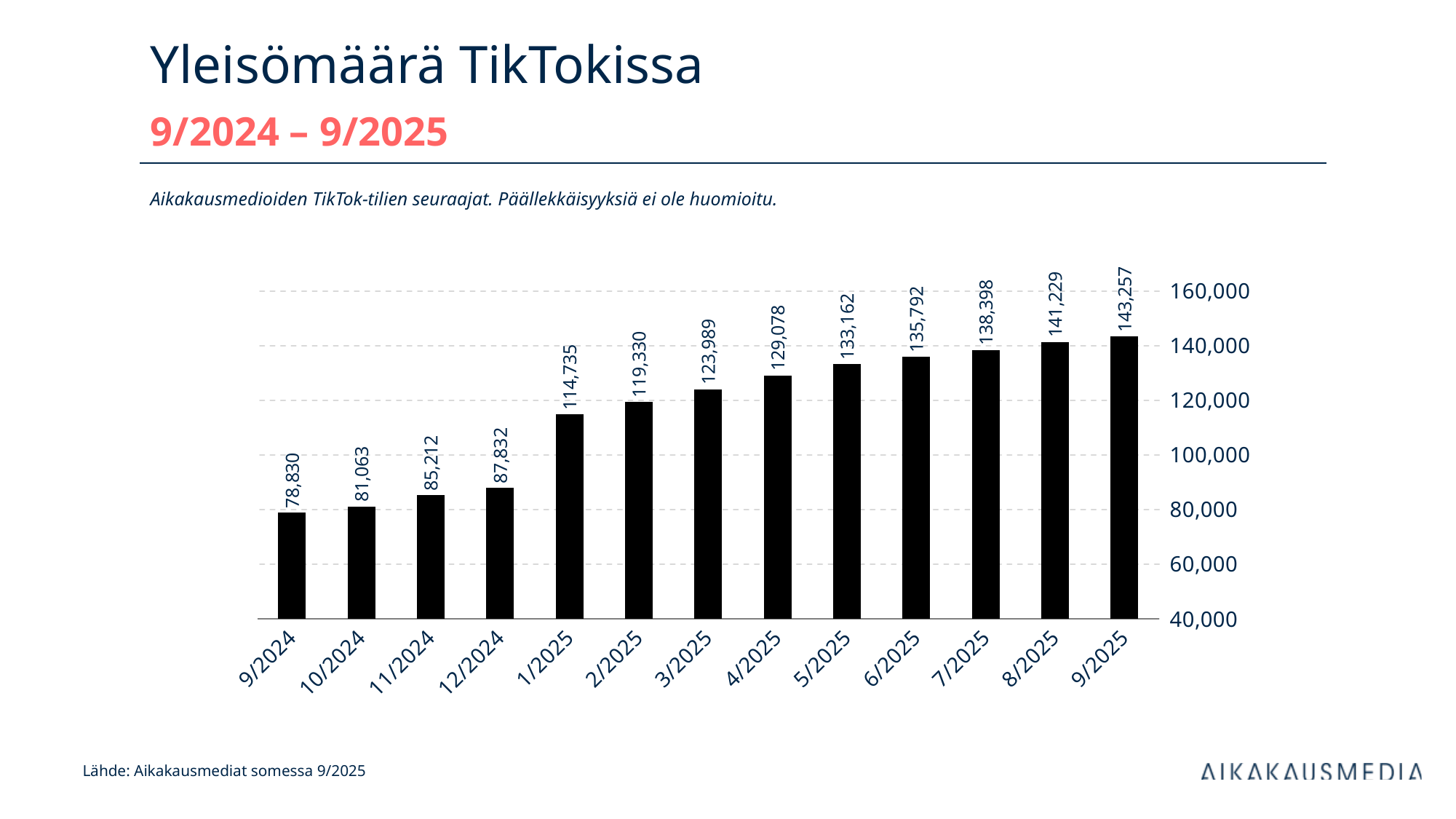
Which month has the lowest value? 9/2024 Which is larger, the value for 3/2025 or the value for 12/2024? 3/2025 Is the value for 8/2025 greater or less than 140,000? greater How many months are shown on the x axis? 13 Which month has the highest value? 9/2025 Do the values rise or fall from 9/2024 to 9/2025? rise What is the value for 5/2025? 133,162 What is the value for 9/2024? 78,830 What is the difference between the values for 1/2025 and 12/2024? 26,903 What is the difference between the values for 9/2025 and 9/2024? 64,427 What kind of chart is shown on the slide? bar chart What is the value for 1/2025? 114,735